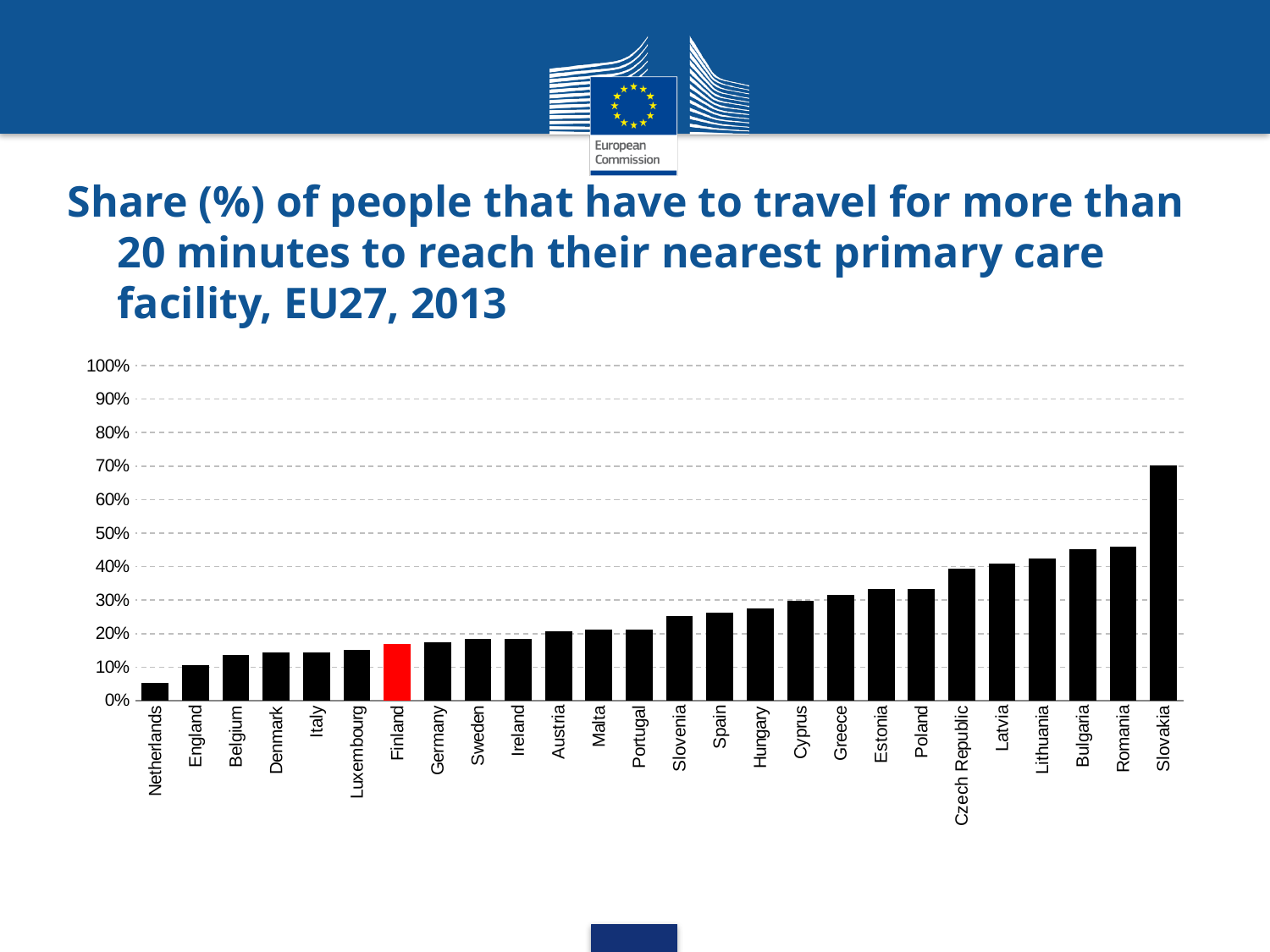
Is the value for Netherlands greater or less than 10%? less How many countries are shown on the x axis of the chart? 26 Is the value for Finland greater or less than 20%? less What kind of chart is shown on the slide? bar chart Is the value for Slovakia greater or less than 60%? greater Which country's bar is coloured red in the chart? Finland Do the values rise or fall moving from left to right along the x axis? rise Which country has the highest share of people travelling more than 20 minutes to their nearest primary care facility? Slovakia Which country has the lowest share of people travelling more than 20 minutes to their nearest primary care facility? Netherlands Which has a larger value, Bulgaria or Finland? Bulgaria